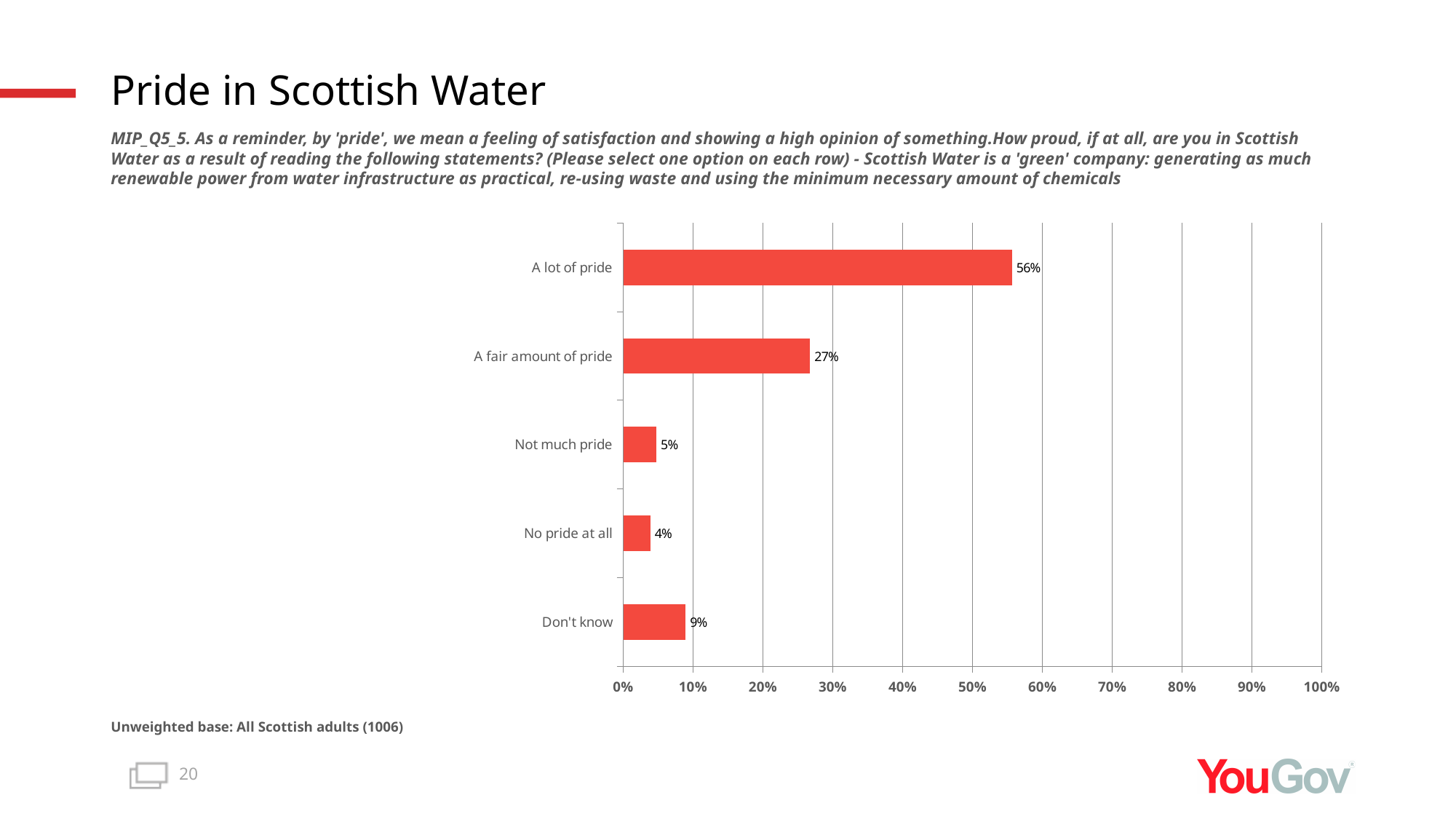
Which category has the lowest value? No pride at all What is the combined value of 'Not much pride' and 'No pride at all'? 9% What type of chart is shown on the slide? Bar chart What is the unweighted base stated below the chart? All Scottish adults (1006) What percentage of respondents said they feel 'A lot of pride'? 56% What is the difference between 'A lot of pride' and 'A fair amount of pride'? 29 percentage points How many categories are shown in the chart? 5 What percentage of respondents answered 'Don't know'? 9% Which category has the highest value? A lot of pride What is the value for 'A fair amount of pride'? 27% Is the value for 'A lot of pride' greater or less than 50%? greater Which is larger: 'Not much pride' or 'Don't know'? Don't know